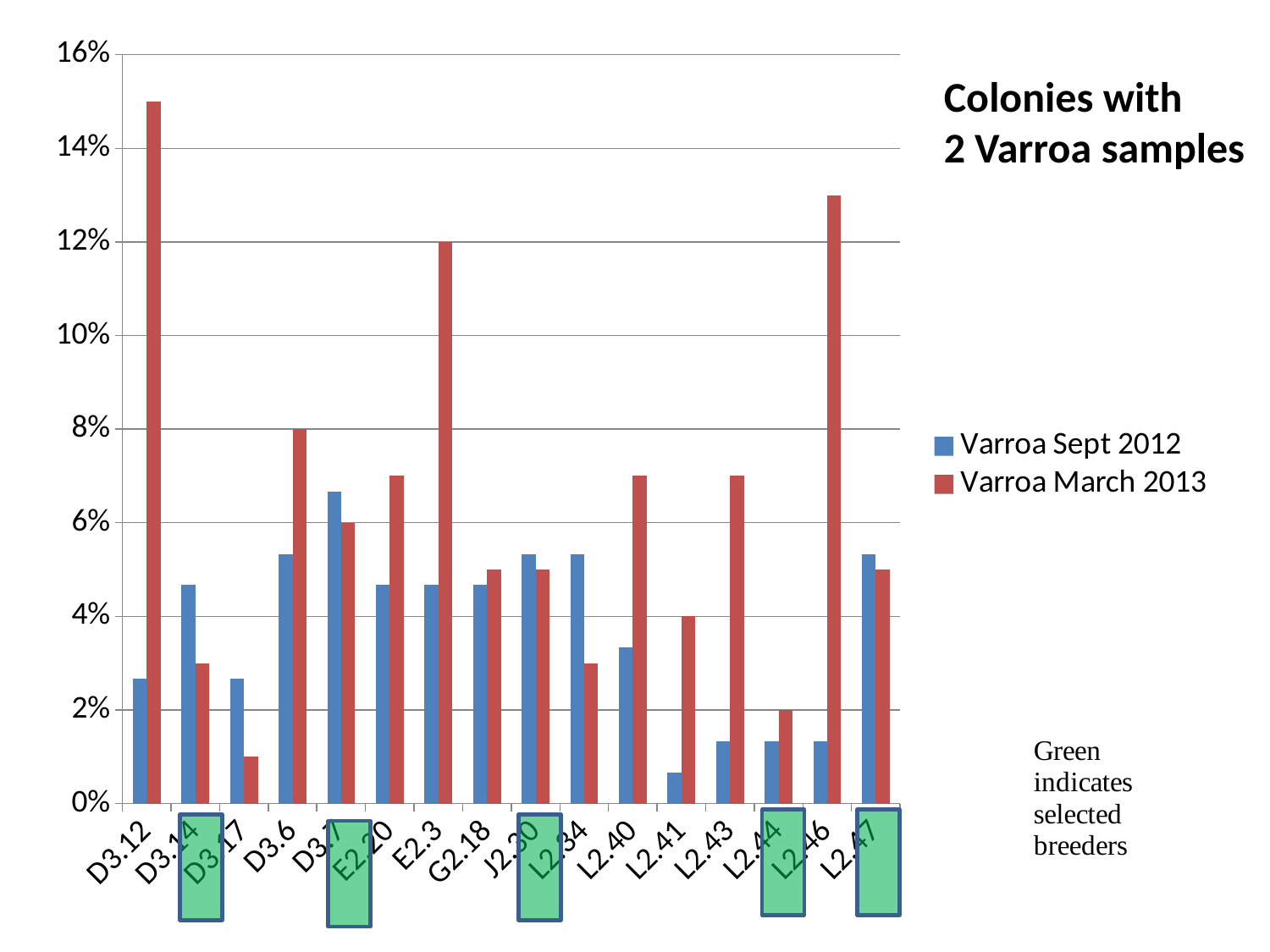
What is the Varroa March 2013 value for colony L2.44? 2% What is the Varroa March 2013 value for colony D3.6? 8% Which colony has the highest Varroa March 2013 value? D3.12 Which colony has the lowest Varroa Sept 2012 value? L2.41 How many series does the legend list? 2 For colony D3.14, which is larger: the Varroa Sept 2012 value or the Varroa March 2013 value? Varroa Sept 2012 According to the note on the slide, what do the green boxes under the x-axis labels indicate? selected breeders What is the Varroa March 2013 value for colony E2.3? 12% Is the Varroa March 2013 value for L2.46 greater or less than 12%? greater What kind of chart is shown on the slide? bar chart Which colony has the highest Varroa Sept 2012 value? D3.7 How many colonies (categories) are shown on the x axis? 16